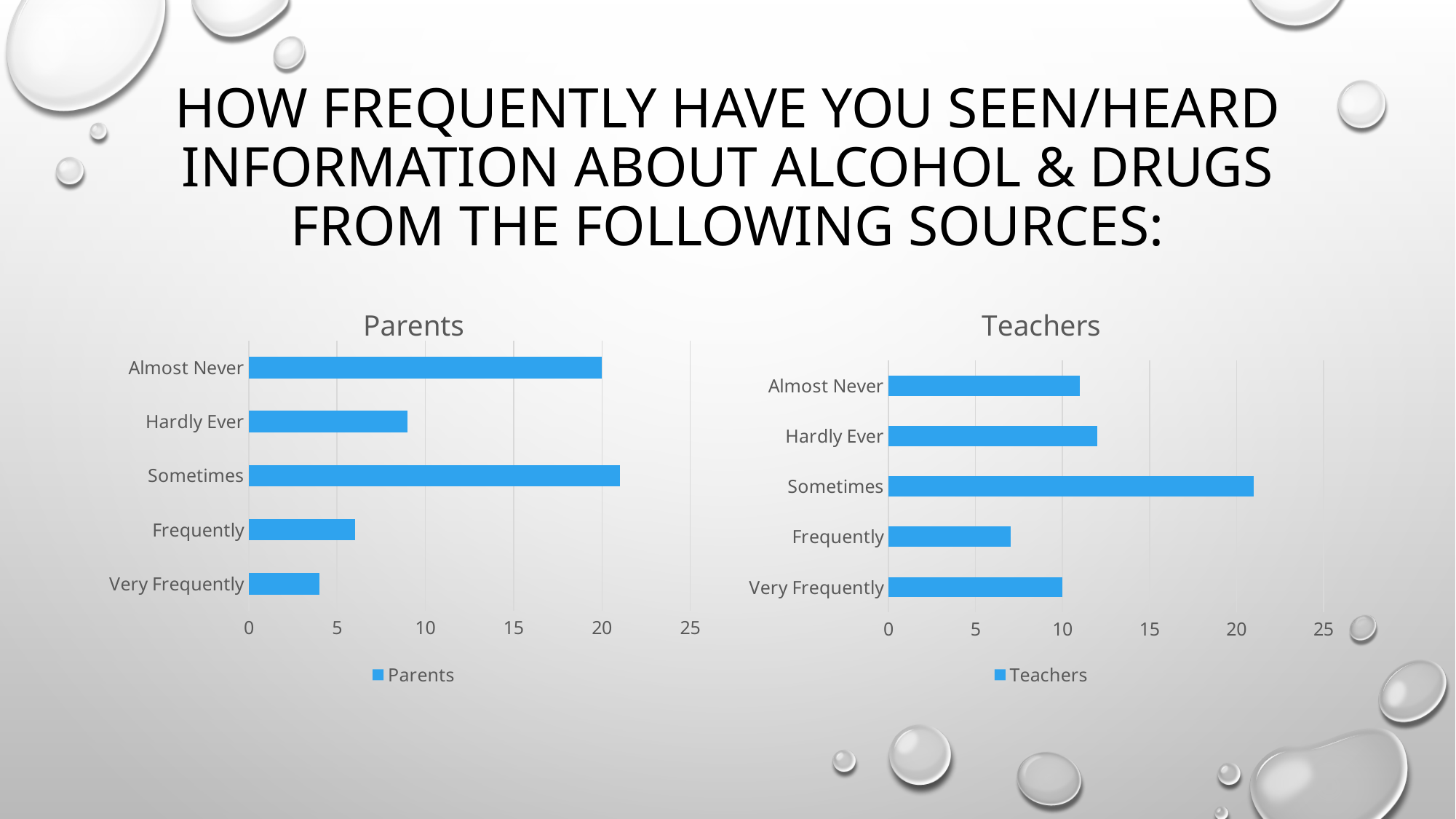
How many series does the legend of the Teachers chart list? 1 In the Parents chart, is the value for Hardly Ever greater or less than 10? less In the Teachers chart, which category has the lowest value? Frequently In the Parents chart, which category has the lowest value? Very Frequently What kind of chart is the Parents chart? bar chart In the Parents chart, what is the value for Almost Never? 20 In the Teachers chart, what is the value for Very Frequently? 10 In the Teachers chart, is the value for Sometimes greater or less than 20? greater How many categories are shown in the Parents chart? 5 In the Parents chart, which is larger: Hardly Ever or Frequently? Hardly Ever In the Teachers chart, which is larger: Almost Never or Frequently? Almost Never In the Teachers chart, which category has the highest value? Sometimes